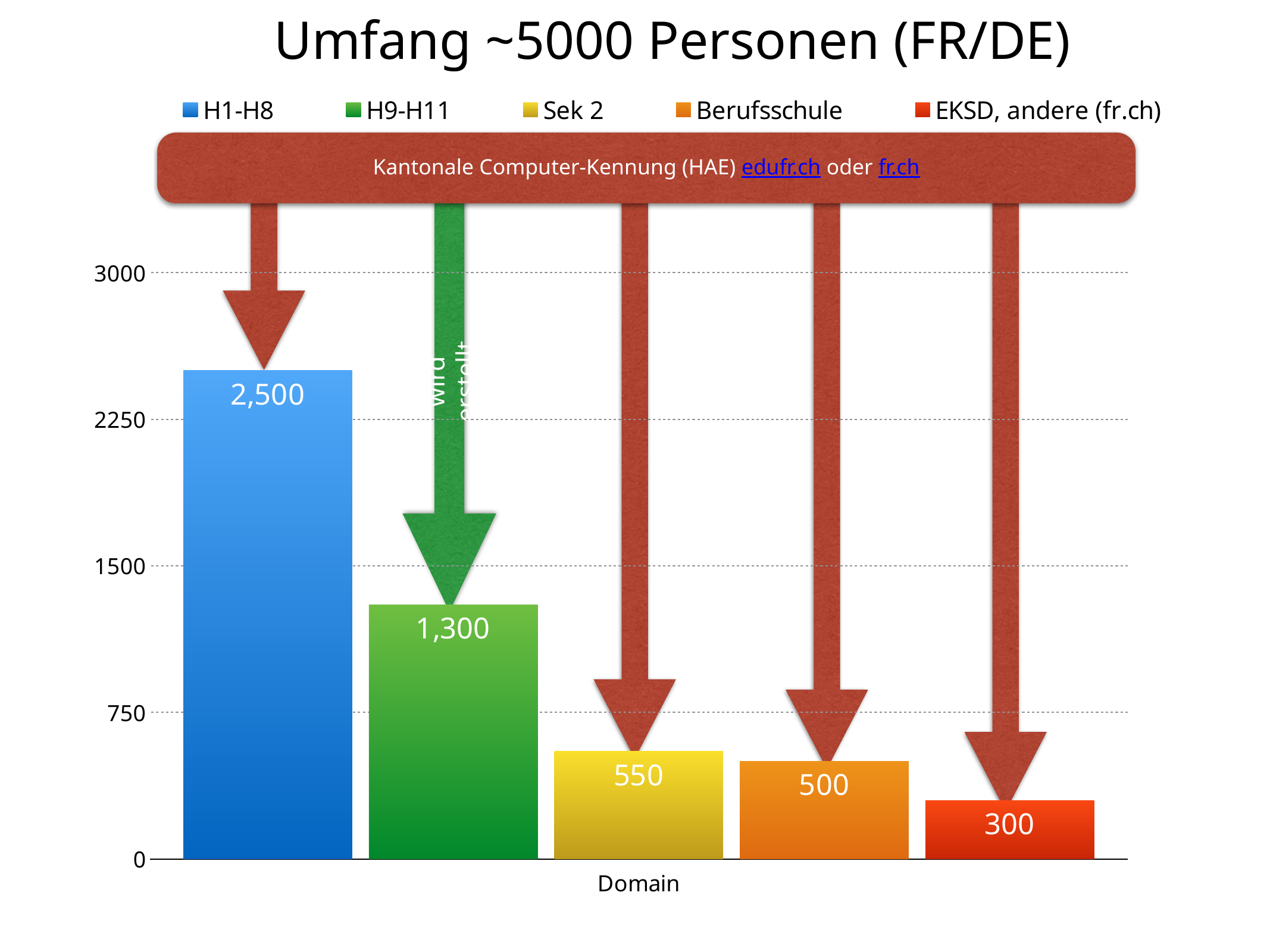
What kind of chart is shown on the slide? bar chart What is the title of the chart? Umfang ~5000 Personen (FR/DE) What is the value for Berufsschule? 500 What is the difference between the values for H1-H8 and H9-H11? 1,200 Which is larger, the value for Sek 2 or the value for Berufsschule? Sek 2 What is the value for H1-H8? 2,500 What is the value for Sek 2? 550 How many series does the legend list? 5 What is the value for H9-H11? 1,300 Which series has the lowest value? EKSD, andere (fr.ch) What is the value for EKSD, andere (fr.ch)? 300 Which series has the highest value? H1-H8